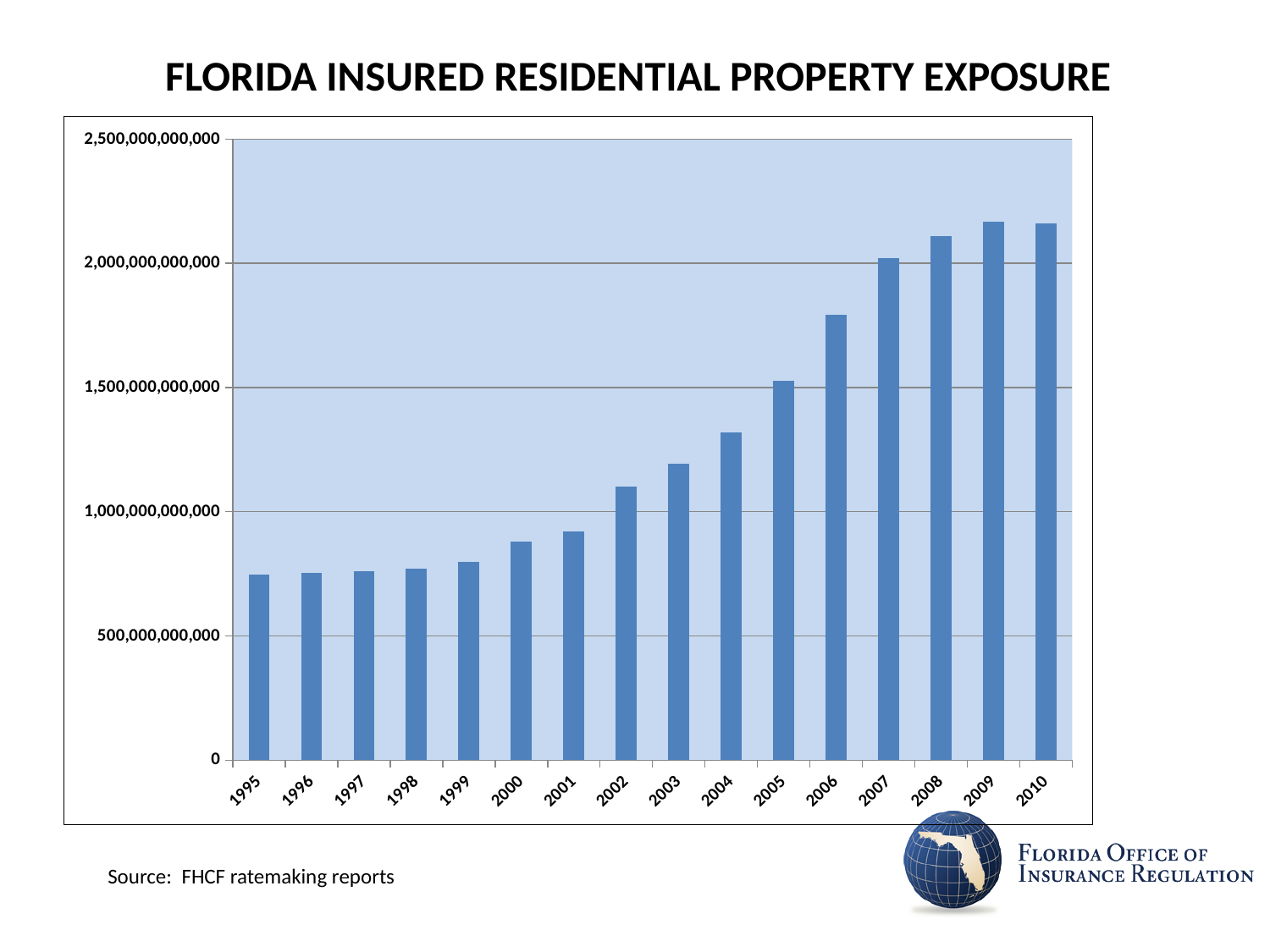
Do the values generally rise or fall from 1995 to 2010? rise How many years are plotted on the x axis of the chart? 16 Is the value for 2008 greater or less than 2,000,000,000,000? greater Is the value for 1995 greater or less than 1,000,000,000,000? less Is the value for 2004 greater or less than 1,500,000,000,000? less What source is cited below the chart? FHCF ratemaking reports Which year has the larger value, 2004 or 2005? 2005 What is the title of the chart? FLORIDA INSURED RESIDENTIAL PROPERTY EXPOSURE What kind of chart is shown on the slide? bar chart